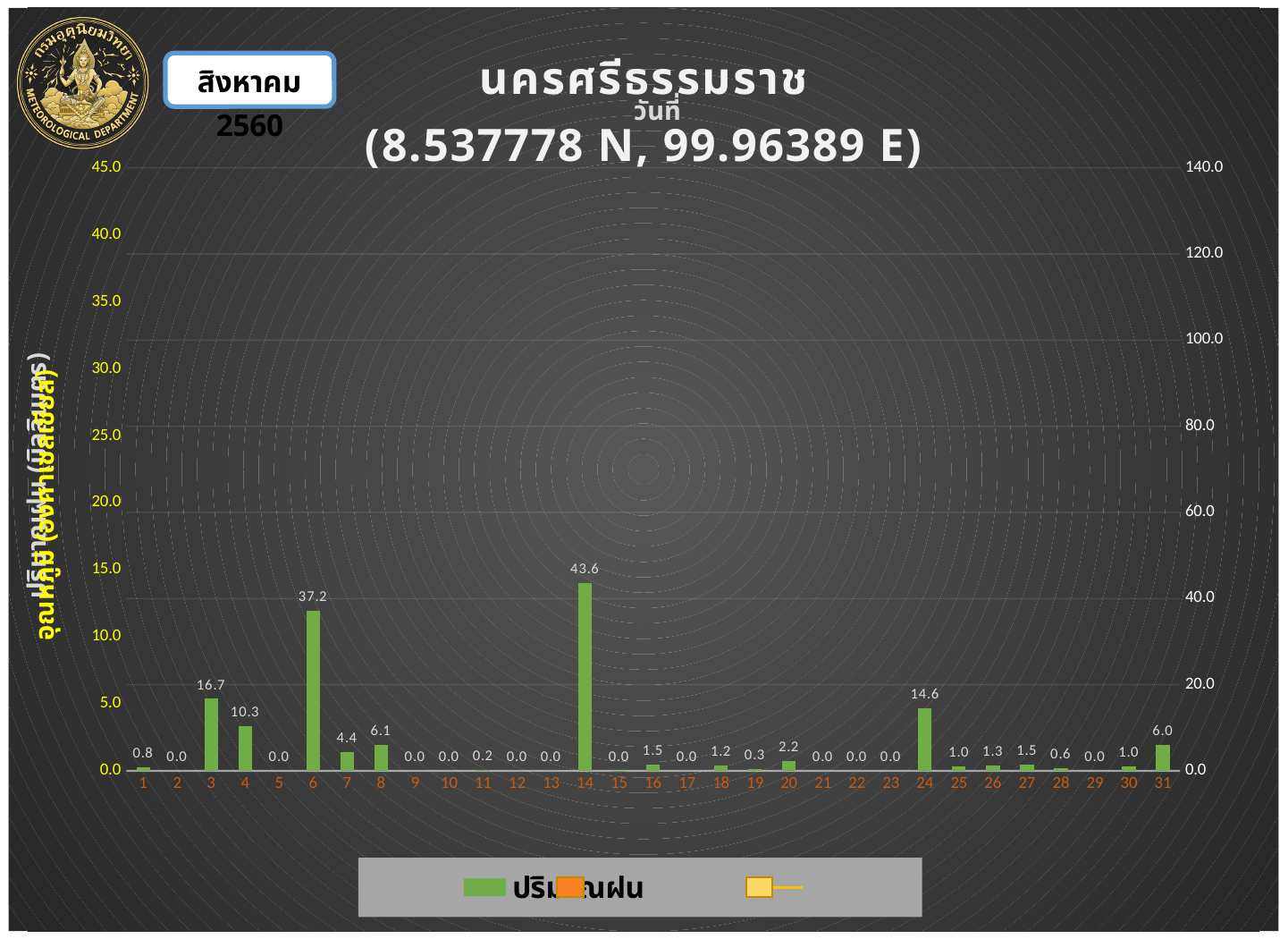
What is the rainfall value shown for day 24? 14.6 Which day has the highest rainfall value? 14 What kind of chart is shown on the slide? bar chart What is the difference between the rainfall values for day 3 and day 4? 6.4 What are the coordinates shown in the chart title? 8.537778 N, 99.96389 E What is the rainfall value shown for day 3? 16.7 What is the difference between the rainfall values for day 14 and day 6? 6.4 What is the rainfall value shown for day 14? 43.6 How many days are shown on the x axis of the chart? 31 Which has a larger rainfall value, day 24 or day 3? day 3 What is the rainfall value shown for day 6? 37.2 Which has a larger rainfall value, day 8 or day 31? day 8